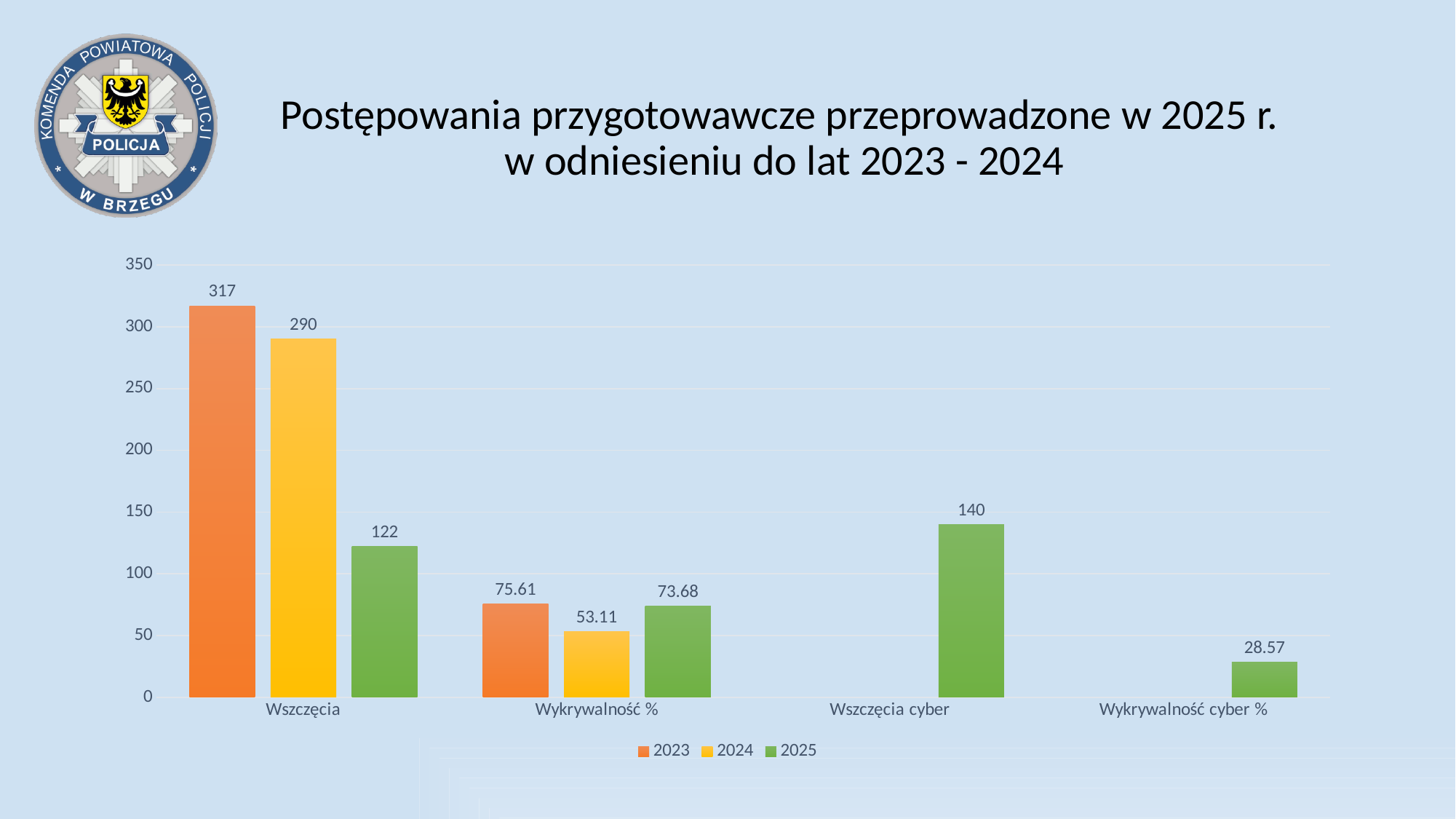
What is the value for 2023 in the Wszczęcia category? 317 What kind of chart is shown on the slide? bar chart Which year has the highest value in the Wszczęcia category? 2023 How many categories are shown on the x axis? 4 What is the value for 2025 in the Wykrywalność cyber % category? 28.57 Which is larger in the Wykrywalność % category, the 2023 value or the 2025 value? 2023 How many series does the legend list? 3 What is the value for 2025 in the Wszczęcia cyber category? 140 What is the value for 2024 in the Wykrywalność % category? 53.11 What is the difference between the 2023 and 2025 values in the Wszczęcia category? 195 Is the 2024 value for Wszczęcia greater or less than 250? greater Which year has the lowest value in the Wykrywalność % category? 2024